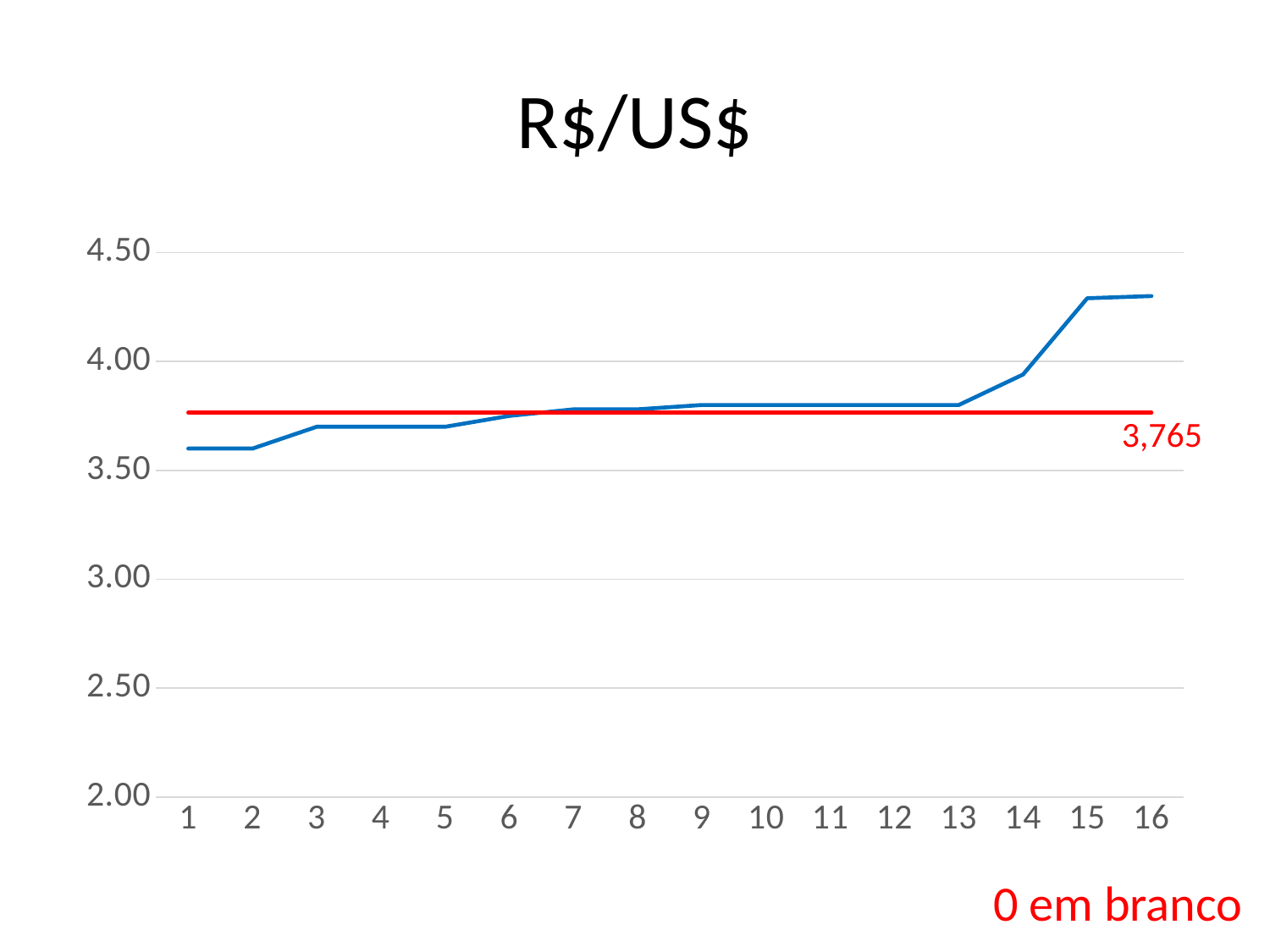
Which is larger, the value at point 16 or the value of the red horizontal line? point 16 Is the value at point 1 greater or less than 4.00? less Is the value at point 8 greater or less than 4.00? less What is the title of the chart? R$/US$ What kind of chart is shown on the slide? line chart How many points are plotted along the x axis of the chart? 16 Is the value at point 1 greater or less than 3.50? greater What colour is the horizontal reference line on the chart? red Which is larger, the value at point 1 or the value at point 16? point 16 Do the values of the blue line rise or fall from point 1 to point 16? rise What value is labelled on the red horizontal line? 3,765